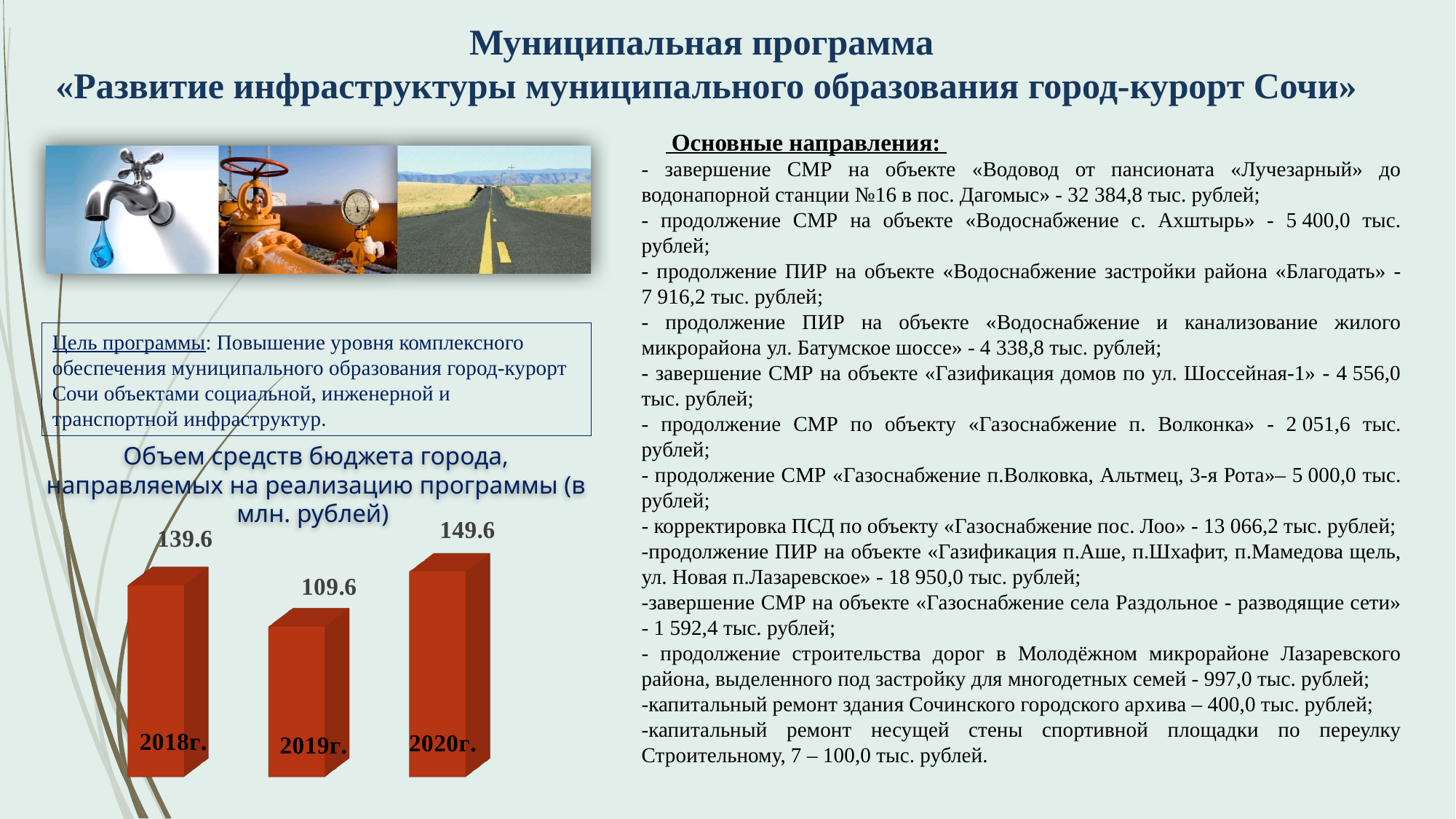
What is the value for 2019г. in the chart? 109.6 What unit does the chart title say the values are in? млн. рублей What kind of chart is shown on the slide? bar chart What is the difference between the values for 2018г. and 2019г.? 30 What is the value for 2018г. in the chart? 139.6 Which year has the highest value in the chart? 2020г. Which year has the lowest value in the chart? 2019г. What is the difference between the values for 2020г. and 2018г.? 10 How many bars are shown in the chart? 3 What is the value for 2020г. in the chart? 149.6 What is the difference between the values for 2020г. and 2019г.? 40 Which is larger, the value for 2018г. or the value for 2020г.? 2020г.